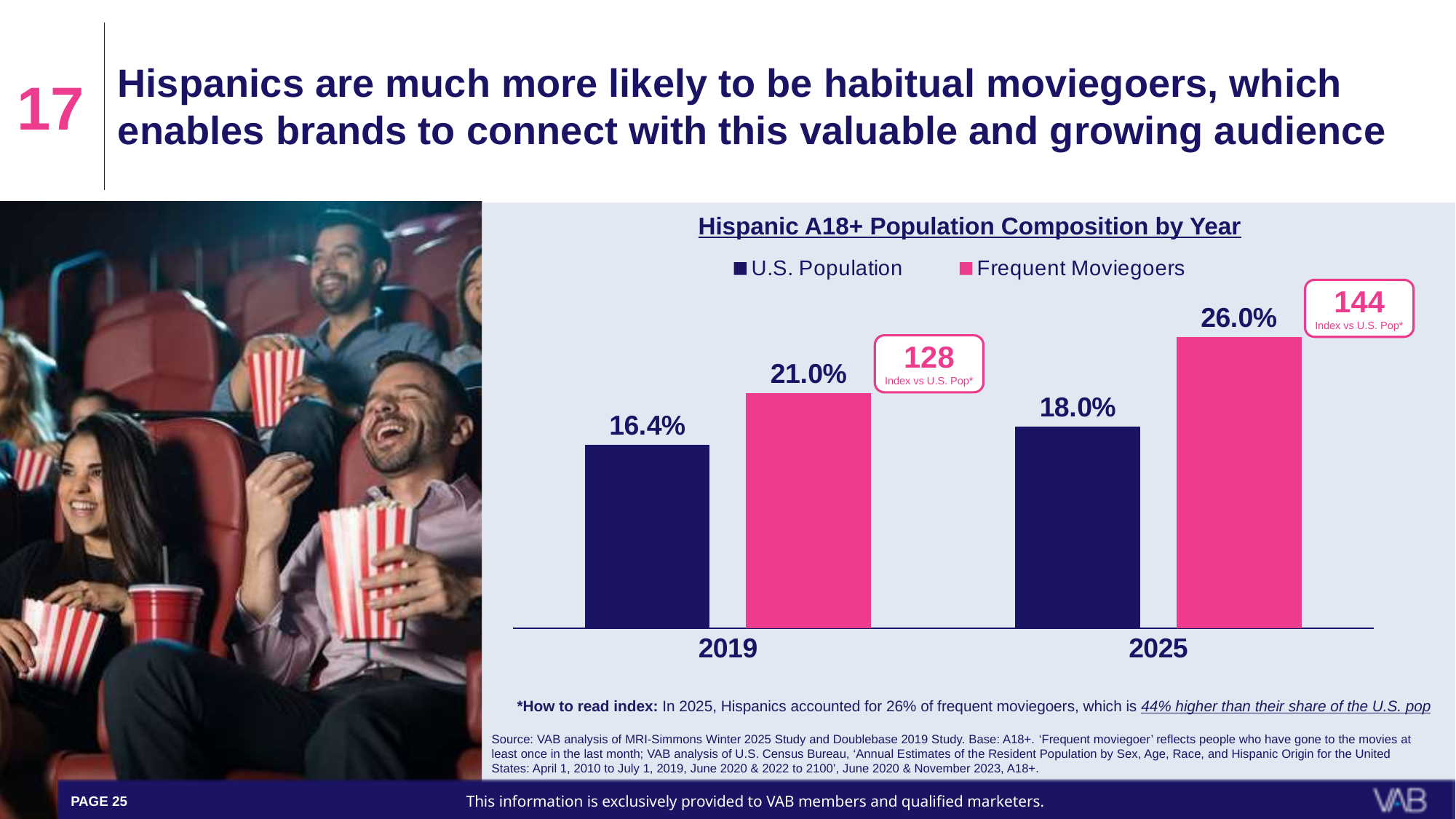
Which is larger in 2019, the U.S. Population value or the Frequent Moviegoers value? Frequent Moviegoers How many years are shown on the x axis? 2 What kind of chart is shown? Bar chart What is the index vs U.S. Pop shown for 2025? 144 What is the Frequent Moviegoers value for 2025? 26.0% What is the difference between the Frequent Moviegoers values for 2025 and 2019? 5.0% What is the U.S. Population value for 2019? 16.4% What is the U.S. Population value for 2025? 18.0% What is the Frequent Moviegoers value for 2019? 21.0% What is the difference between the Frequent Moviegoers and U.S. Population values in 2025? 8.0% Which year has the highest Frequent Moviegoers value? 2025 How many series does the legend list? 2